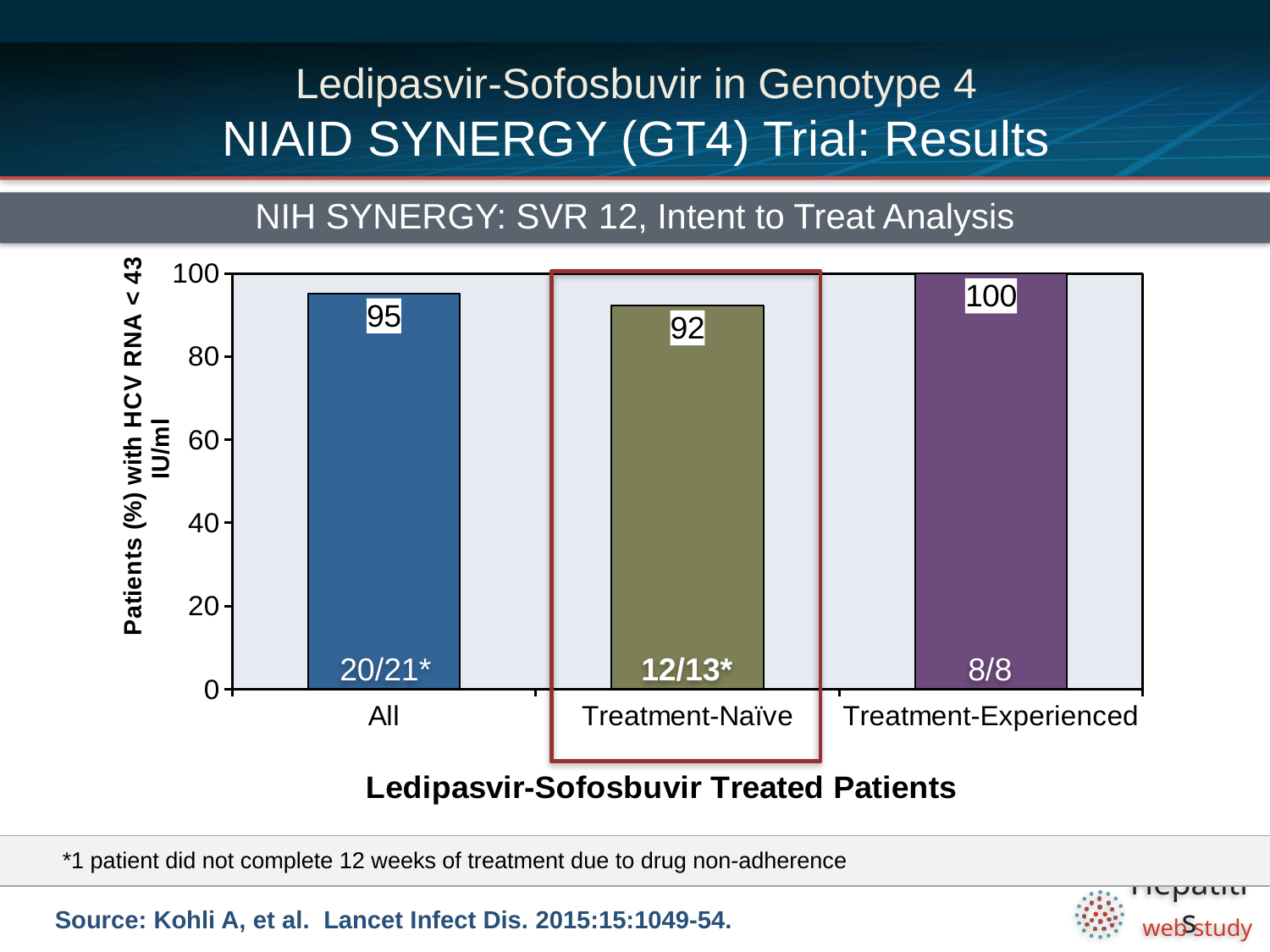
What fraction of patients is printed on the Treatment-Naïve bar? 12/13* How many categories are shown on the x axis? 3 What is the value for the All group? 95 What is the value for the Treatment-Experienced group? 100 Which category has the lowest value? Treatment-Naïve Which category has the highest value? Treatment-Experienced What is the title of the chart? NIH SYNERGY: SVR 12, Intent to Treat Analysis What is the value for the Treatment-Naïve group? 92 Which is larger, the value for All or the value for Treatment-Experienced? Treatment-Experienced What is the difference between the Treatment-Experienced and Treatment-Naïve values? 8 What kind of chart is shown on the slide? Bar chart What is the difference between the All and Treatment-Naïve values? 3